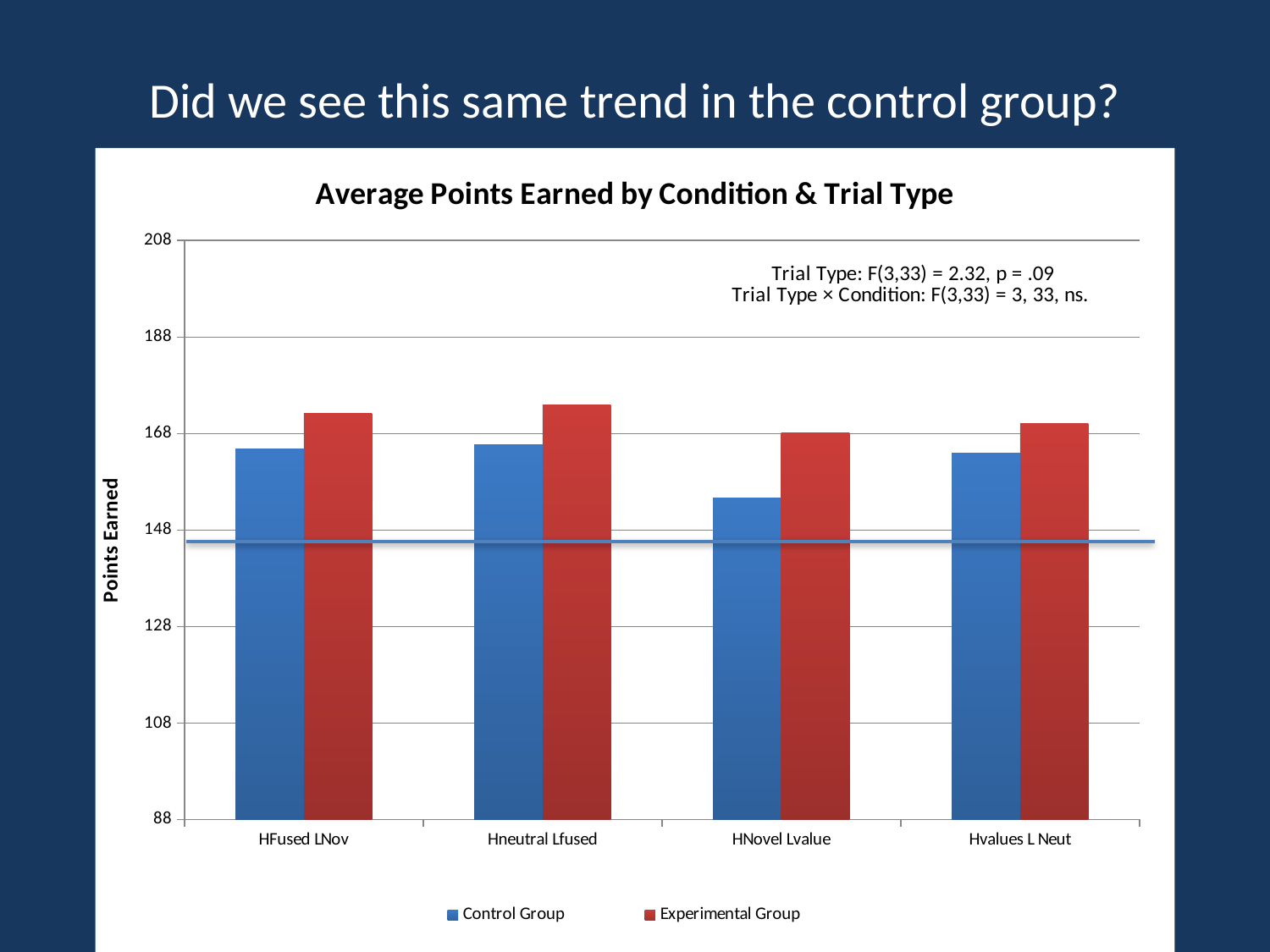
How many trial-type categories are shown on the x axis? 4 For HNovel Lvalue, which series has the larger value, Control Group or Experimental Group? Experimental Group Is the Control Group value for HFused LNov greater or less than 148? greater Which category has the lowest value for the Control Group? HNovel Lvalue What kind of chart is shown on the slide? Bar chart What is the title of the chart? Average Points Earned by Condition & Trial Type How many series does the legend list? 2 Which colour represents the Experimental Group in the chart? Red What is the label on the vertical axis? Points Earned Is the Experimental Group value for Hneutral Lfused greater or less than 168? greater Is the Control Group value for HNovel Lvalue greater or less than 168? less For the Control Group, which is larger: HFused LNov or HNovel Lvalue? HFused LNov